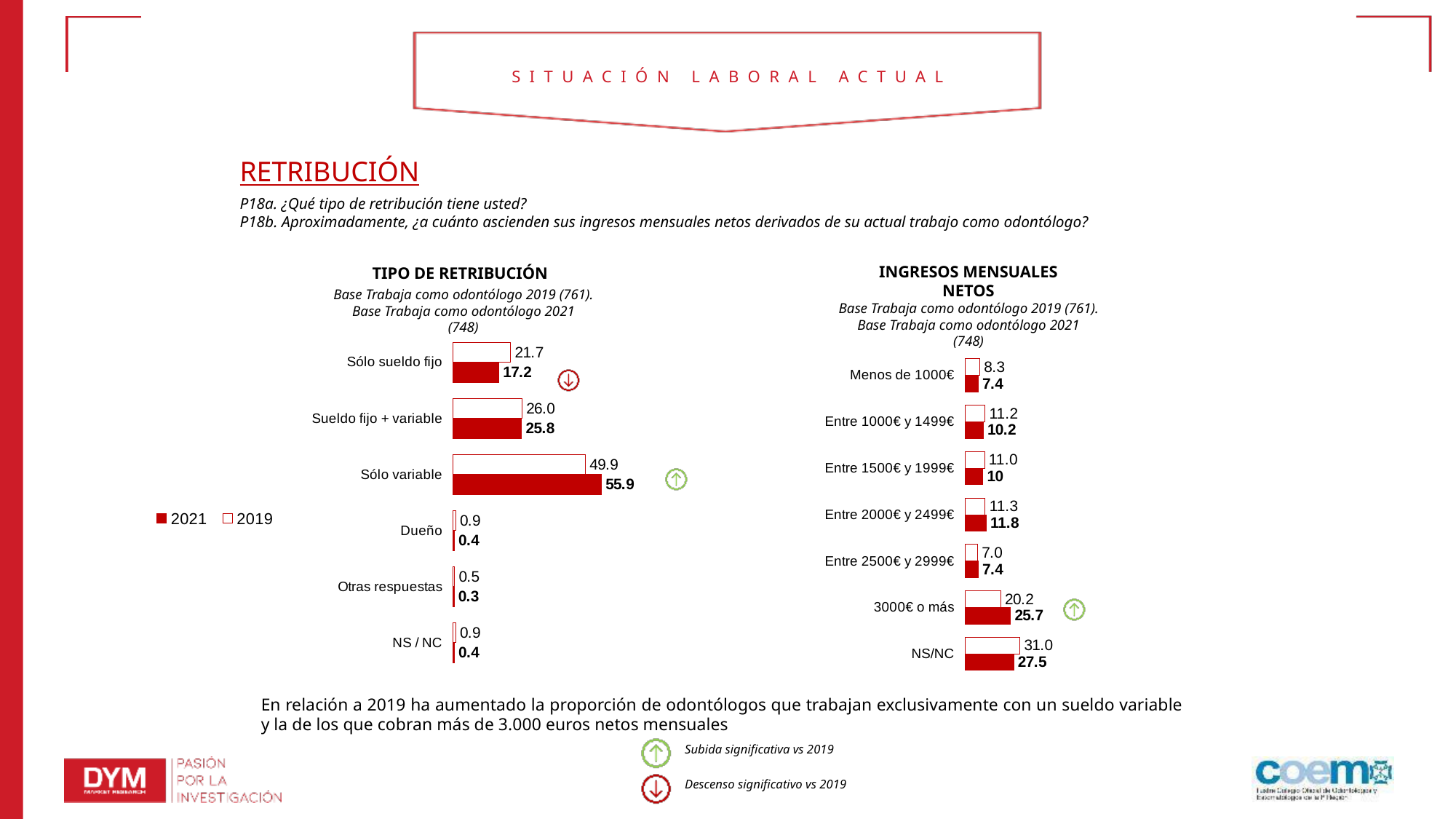
In the 'TIPO DE RETRIBUCIÓN' chart, what is the 2019 value for 'Sólo sueldo fijo'? 21.7 In the 'INGRESOS MENSUALES NETOS' chart, what is the difference between the 2019 and 2021 values for 'NS/NC'? 3.5 In the 'INGRESOS MENSUALES NETOS' chart, what is the 2019 value for 'NS/NC'? 31.0 In the 'TIPO DE RETRIBUCIÓN' chart, how many categories are shown? 6 In the 'TIPO DE RETRIBUCIÓN' chart, what is the 2021 value for 'Sólo variable'? 55.9 In the 'TIPO DE RETRIBUCIÓN' chart, which category has the highest 2021 value? Sólo variable In the 'INGRESOS MENSUALES NETOS' chart, what is the 2021 value for '3000€ o más'? 25.7 In the 'TIPO DE RETRIBUCIÓN' chart, what is the difference between the 2021 and 2019 values for 'Sólo variable'? 6.0 In the 'INGRESOS MENSUALES NETOS' chart, which category has the lowest 2019 value? Entre 2500€ y 2999€ In the 'INGRESOS MENSUALES NETOS' chart, is the 2021 value for 'Entre 2000€ y 2499€' larger or smaller than the 2019 value? larger How many series does the legend list for the charts? 2 What type of chart is the 'TIPO DE RETRIBUCIÓN' chart? Bar chart